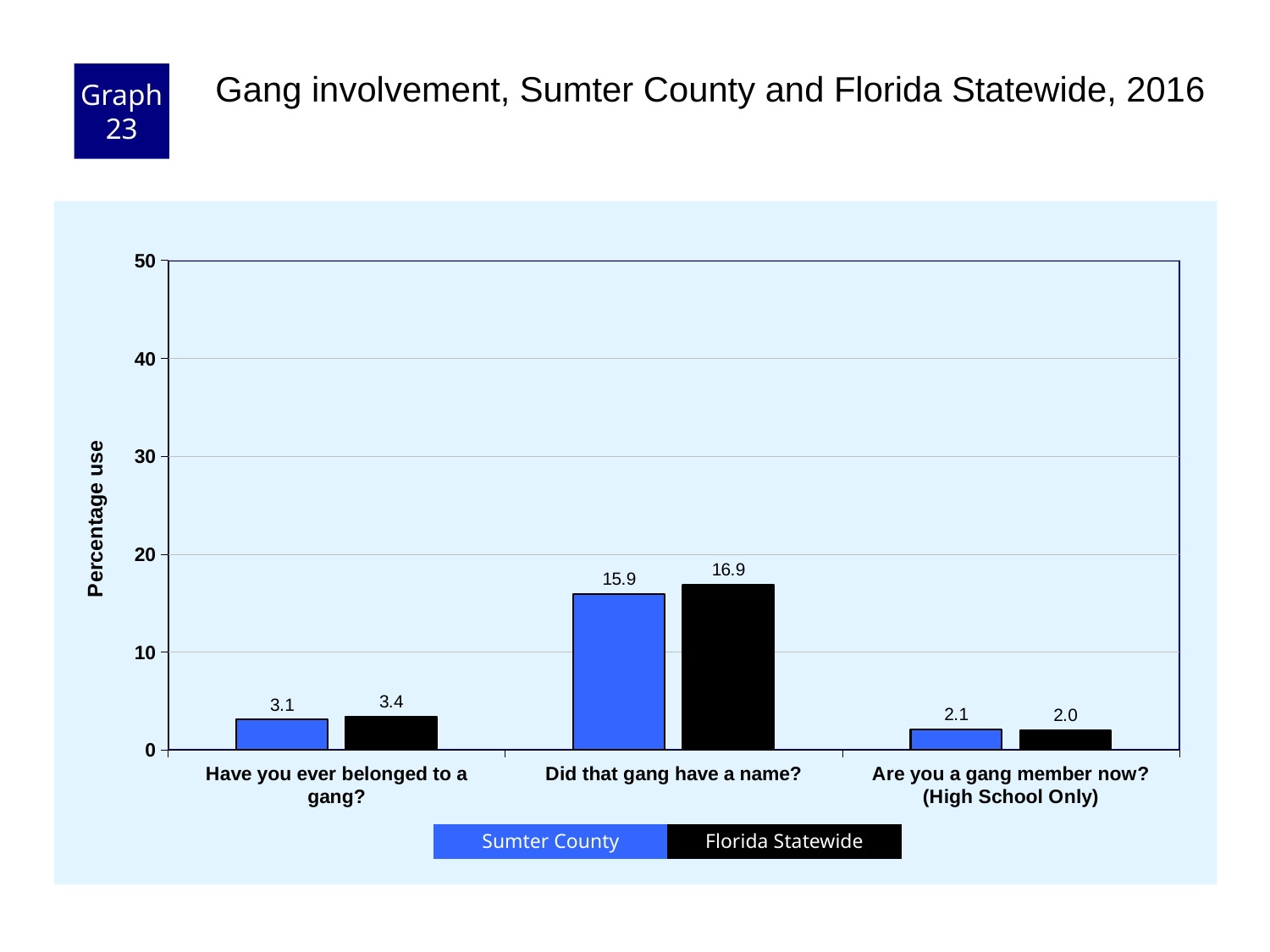
For "Have you ever belonged to a gang?", which is larger: Sumter County or Florida Statewide? Florida Statewide How many questions (categories) are shown on the x axis? 3 What is the Sumter County value for "Are you a gang member now? (High School Only)"? 2.1 What is the Sumter County value for "Did that gang have a name?"? 15.9 Which question has the lowest Sumter County value? Are you a gang member now? (High School Only) Which question has the highest Florida Statewide value? Did that gang have a name? What is the difference between the Florida Statewide and Sumter County values for "Did that gang have a name?"? 1.0 Is the Florida Statewide value for "Did that gang have a name?" greater or less than 20? less What is the Florida Statewide value for "Have you ever belonged to a gang?"? 3.4 What is the label of the y axis? Percentage use What kind of chart is shown on the slide? bar chart How many series does the legend list? 2